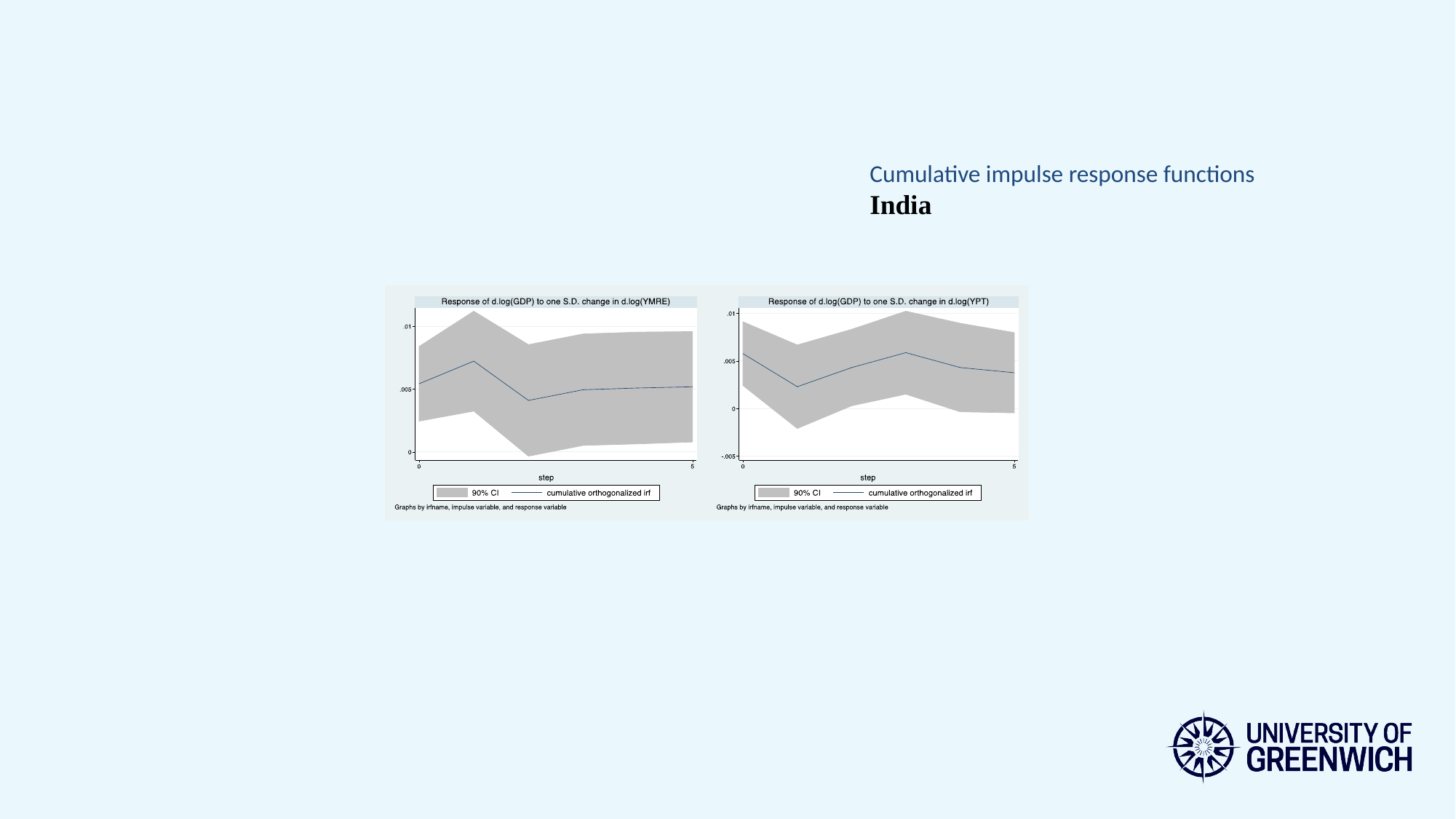
In the left chart (YMRE), at which step is the cumulative orthogonalized irf lowest? 2 In the right chart (YPT), is the cumulative orthogonalized irf at step 1 greater or less than .005? less What does the grey shaded band represent in the right chart (YPT), according to the legend? 90% CI In the right chart (YPT), at which step is the cumulative orthogonalized irf lowest? 1 In the right chart (YPT), is the cumulative orthogonalized irf at step 5 greater or less than .005? less In the left chart (YMRE), which is larger: the cumulative orthogonalized irf at step 1 or at step 2? Step 1 In the right chart (YPT), does the cumulative orthogonalized irf rise or fall from step 0 to step 1? Fall What kind of chart is the left chart, 'Response of d.log(GDP) to one S.D. change in d.log(YMRE)'? Line chart How many entries does the legend list in the right chart, 'Response of d.log(GDP) to one S.D. change in d.log(YPT)'? 2 In the left chart (YMRE), is the cumulative orthogonalized irf at step 1 greater or less than .005? greater In the left chart (YMRE), at which step is the cumulative orthogonalized irf highest? 1 How many steps are plotted along the x axis of the left chart (YMRE), from 0 to 5? 6